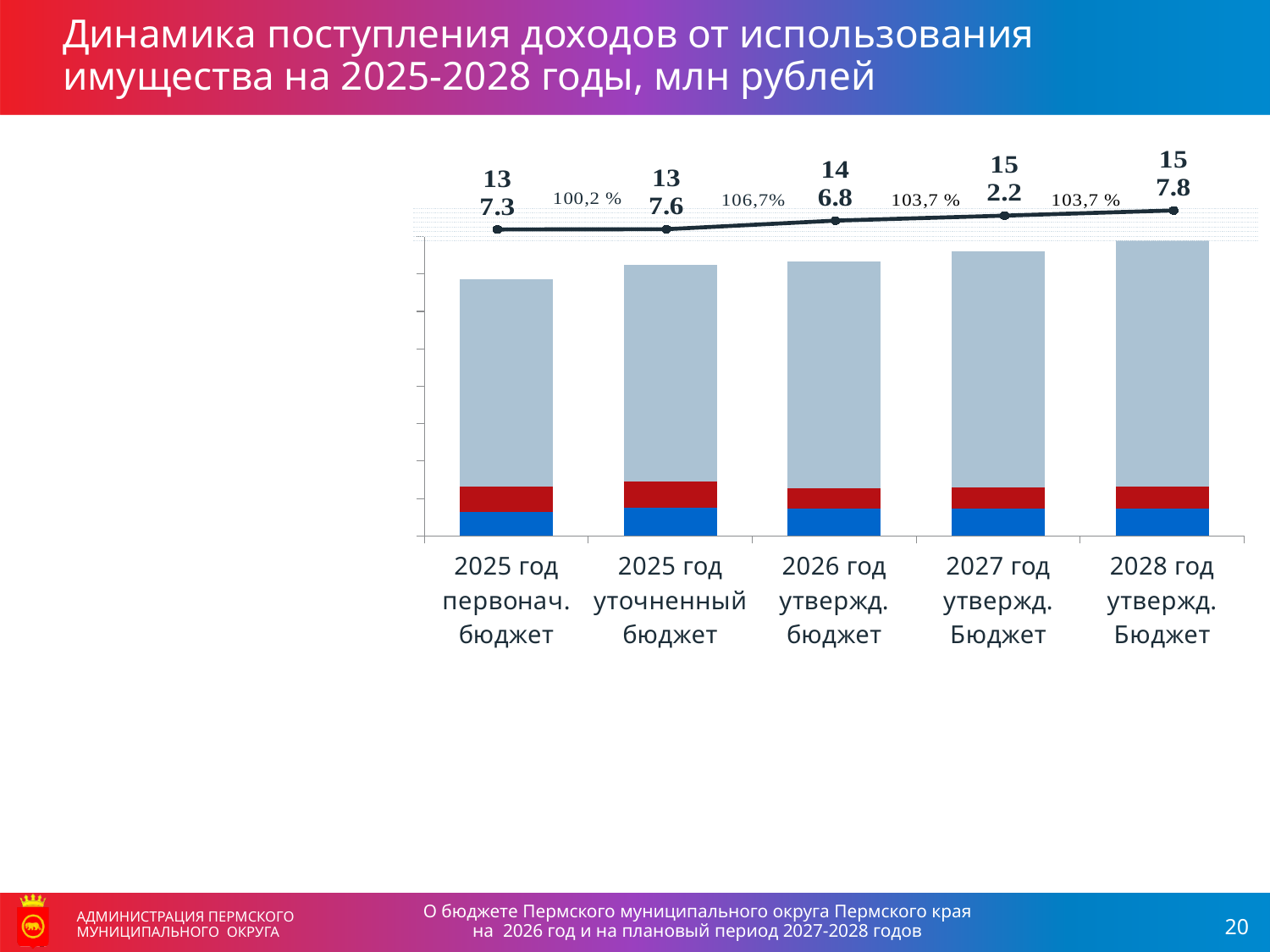
Which category has the lowest value? 2025 год первонач. бюджет Which is larger, the value for 2026 год утвержд. бюджет or for 2027 год утвержд. Бюджет? 2027 год утвержд. Бюджет What is the difference between the values for 2028 год утвержд. Бюджет and 2027 год утвержд. Бюджет? 5.6 Which category has the highest value? 2028 год утвержд. Бюджет What is the value labelled for 2025 год первонач. бюджет? 137.3 What is the value labelled for 2028 год утвержд. Бюджет? 157.8 How many categories are shown along the x axis? 5 What is the value labelled for 2026 год утвержд. бюджет? 146.8 What kind of chart is shown on the slide? combination bar and line chart What is the difference between the values for 2026 год утвержд. бюджет and 2025 год уточненный бюджет? 9.2 What percentage is printed between 2025 год уточненный бюджет and 2026 год утвержд. бюджет? 106,7% Do the values rise or fall from left to right along the x axis? rise